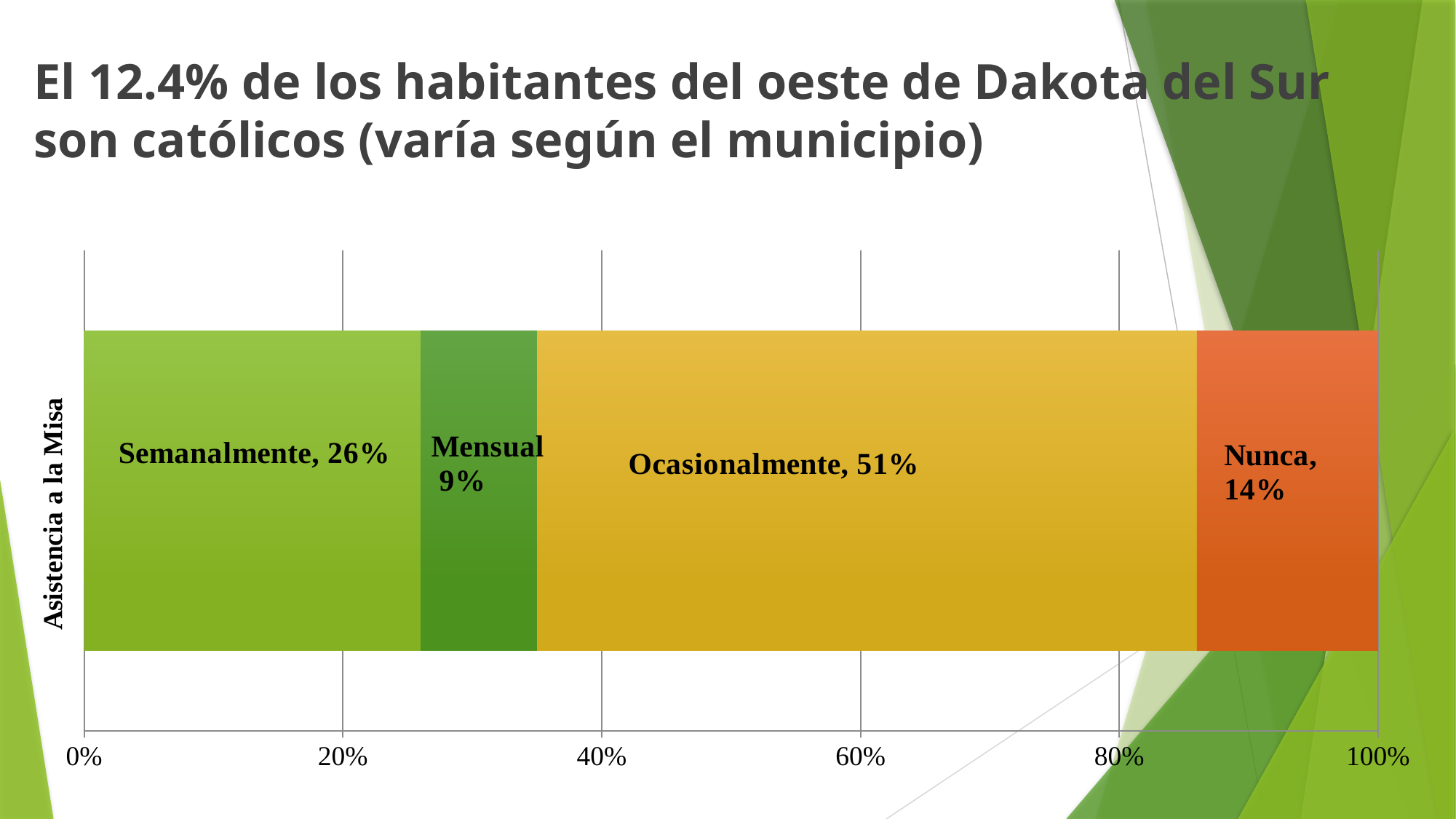
What kind of chart is shown on the slide? Stacked bar chart What is the label on the vertical axis of the chart? Asistencia a la Misa What percentage is shown for Nunca? 14% Which is larger, the Semanalmente value or the Nunca value? Semanalmente Which segment of the bar has the smallest value? Mensual How many segments make up the stacked bar? 4 What percentage of the bar is labelled Semanalmente? 26% What is the difference between the Ocasionalmente and Semanalmente percentages? 25% Which segment of the bar has the largest value? Ocasionalmente What percentage is shown for Ocasionalmente? 51% What percentage is shown for Mensual? 9% Is the value for Ocasionalmente greater or less than 40%? greater